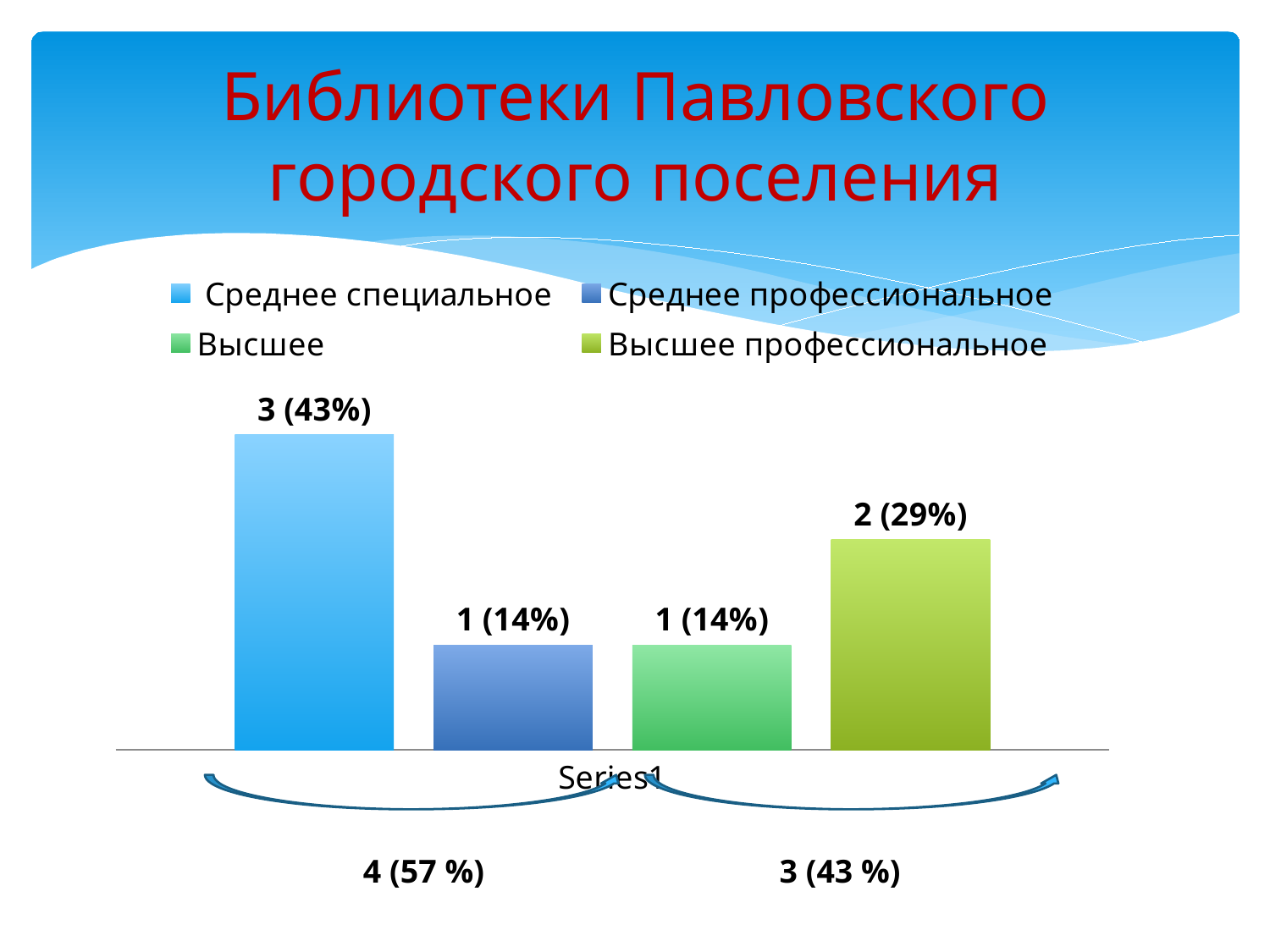
What type of chart is shown on the slide? bar chart What is the data label on the bar for Среднее специальное? 3 (43%) How many bars are plotted in the chart? 4 Which is larger, the value for Среднее специальное or the value for Высшее профессиональное? Среднее специальное What is the difference between the count for Среднее специальное and the count for Высшее? 2 What is the data label on the bar for Среднее профессиональное? 1 (14%) How many series does the legend list? 4 What is the data label on the bar for Высшее профессиональное? 2 (29%) What is the difference between the count for Высшее профессиональное and the count for Среднее профессиональное? 1 Which series has the highest bar? Среднее специальное What label is shown on the category axis below the bars? Series1 What is the data label on the bar for Высшее? 1 (14%)